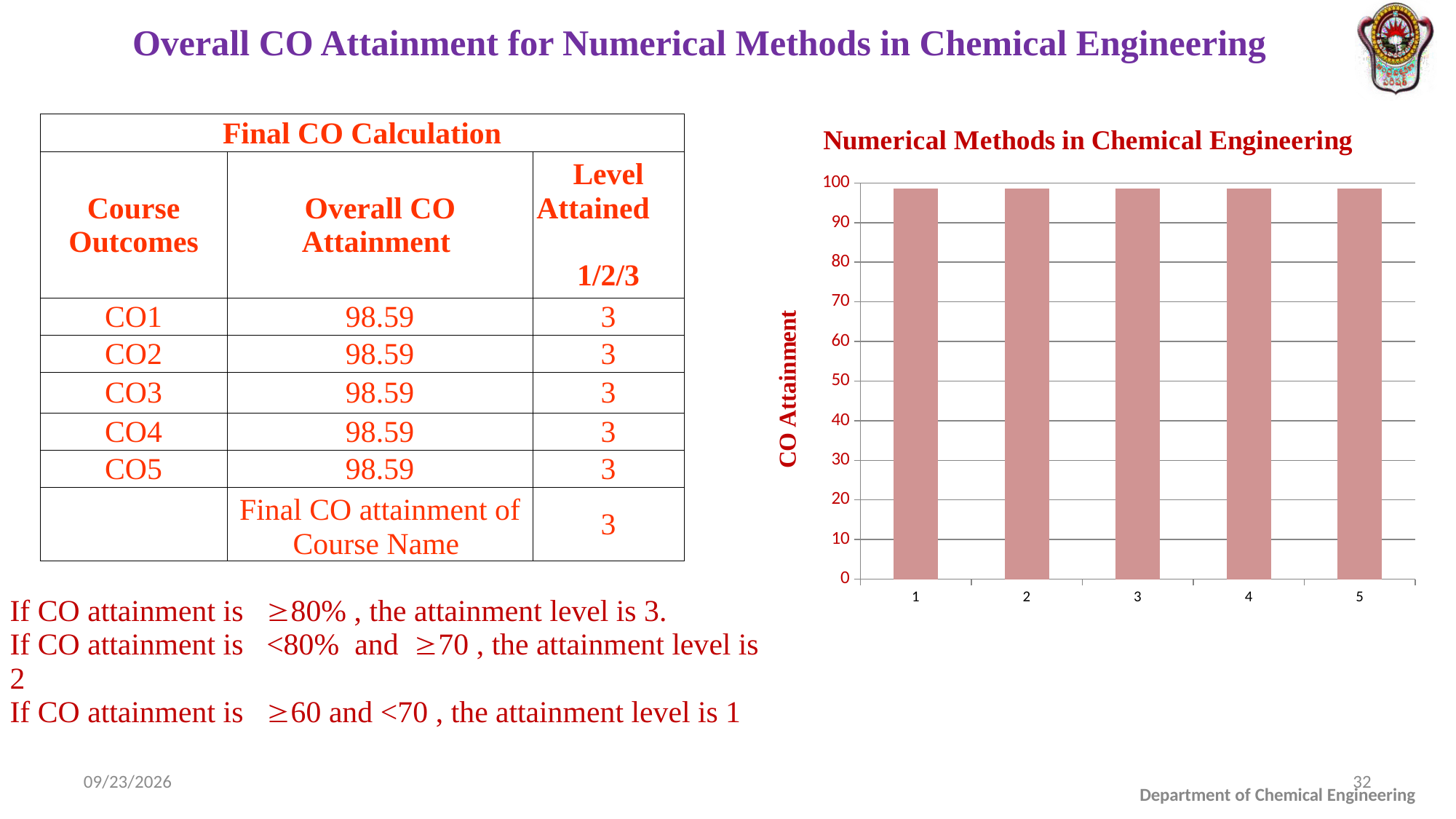
What is the title of the chart? Numerical Methods in Chemical Engineering Is the value for category 3 greater or less than 80? greater What is the label on the vertical axis of the chart? CO Attainment Is the value for category 2 greater or less than 50? greater Do the bar values rise, fall, or stay roughly the same from category 1 to category 5? stay roughly the same Is the value for category 4 greater or less than 70? greater What is the highest tick value shown on the vertical axis? 100 How many bars are plotted in the chart? 5 What kind of chart is shown on the slide? bar chart